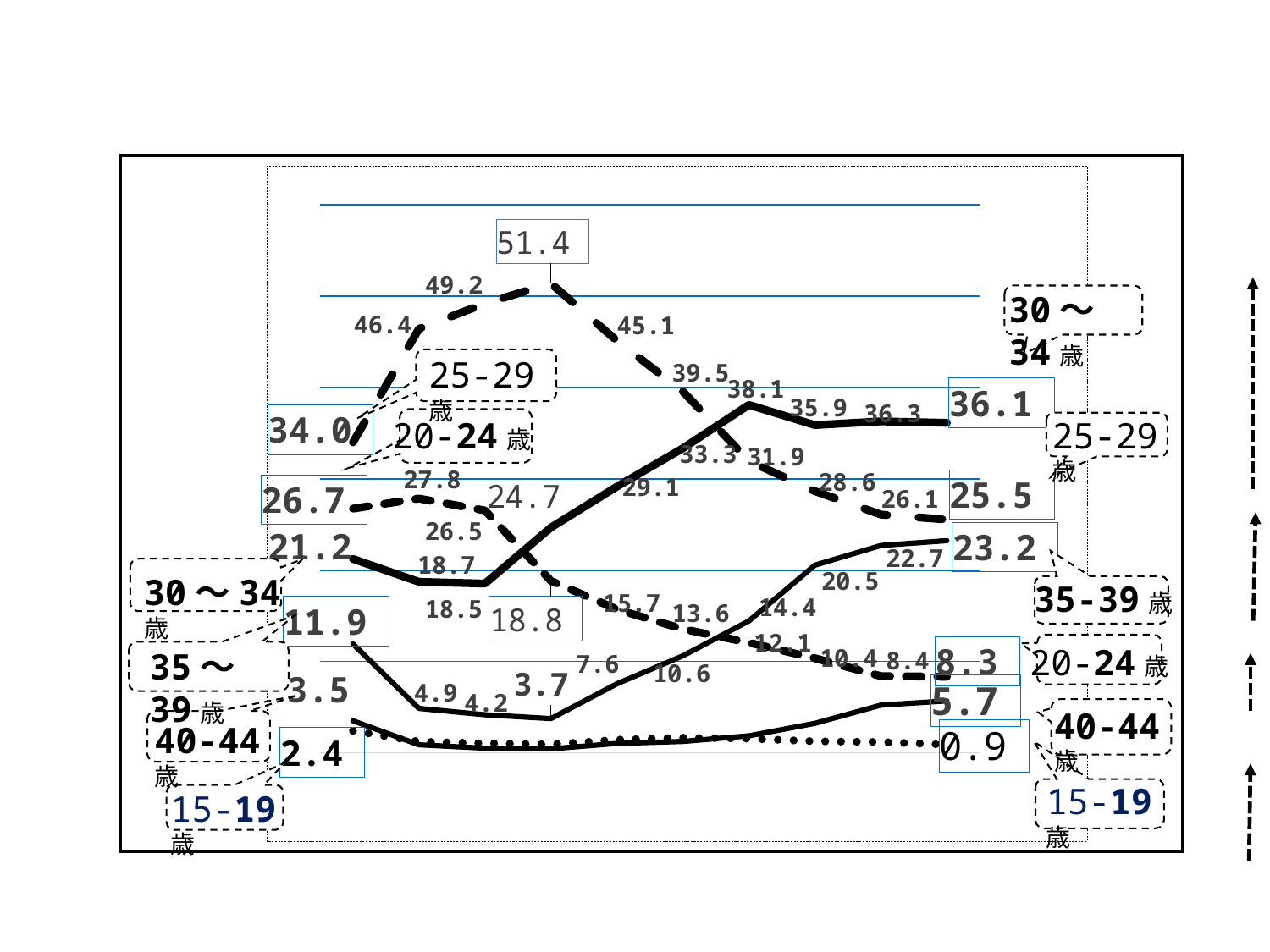
What is the value of the 20-24歳 series at the rightmost point? 8.3 What kind of chart is shown on the slide? line chart At the rightmost point, which series has the larger value: 30-34歳 or 25-29歳? 30-34歳 What is the value of the 30-34歳 series at the rightmost point? 36.1 What is the lowest value labelled at the right end of the chart, and which series does it belong to? 0.9, 15-19歳 What is the value of the 25-29歳 series at the leftmost point? 34.0 What is the difference between the leftmost value (34.0) and the rightmost value (25.5) of the 25-29歳 series? 8.5 Does the 20-24歳 series rise or fall overall from left to right? fall What is the highest value labelled on the chart, and which series does it belong to? 51.4, 25-29歳 How many age-group series are plotted on the chart? 6 By how much does the 30-34歳 series change from its leftmost value (21.2) to its rightmost value (36.1)? 14.9 What is the value of the 35-39歳 series at the leftmost point? 11.9